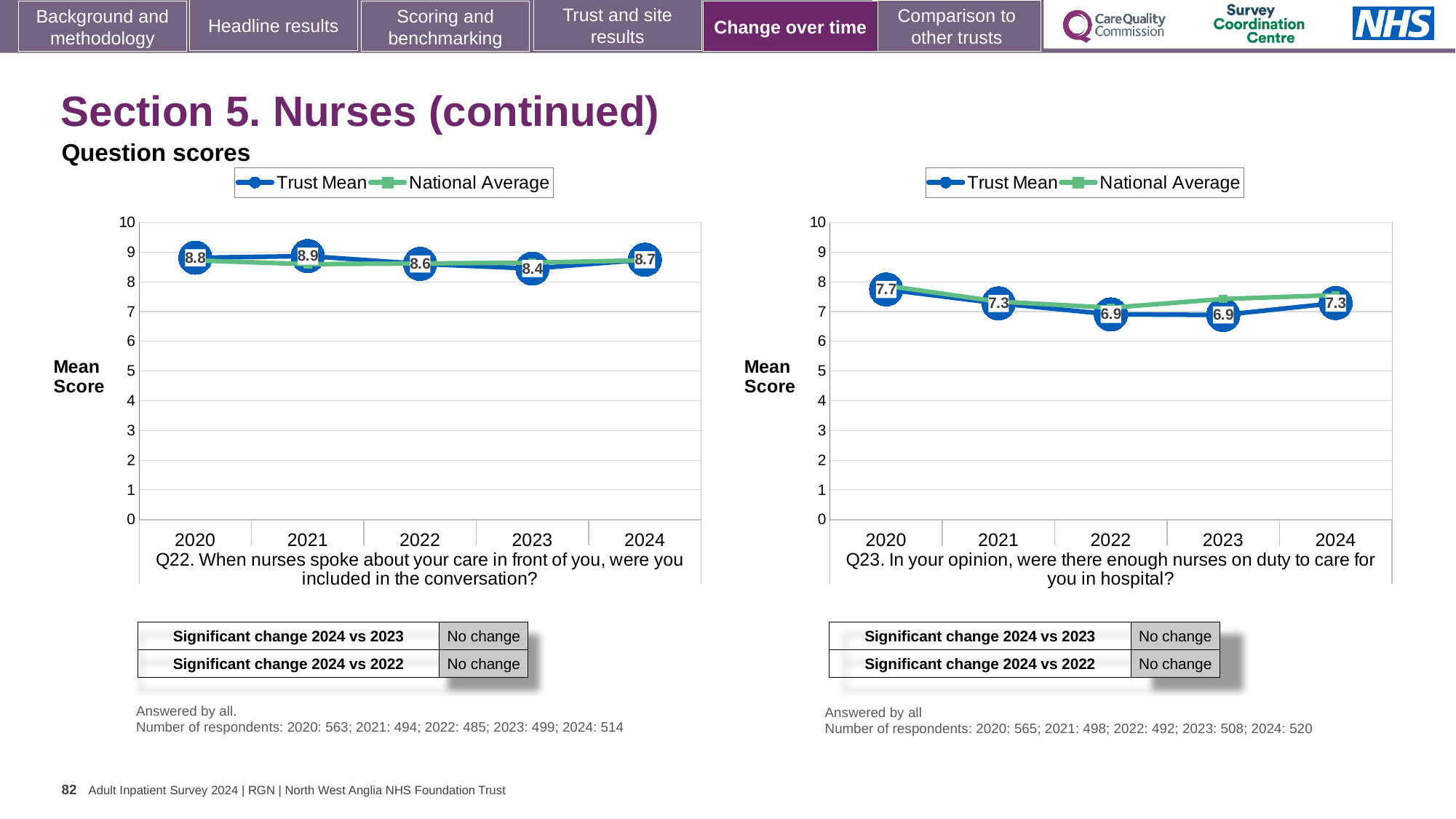
On the Q22 chart (left), what is the Trust Mean score for 2023? 8.4 How many years are plotted on the x axis of the Q22 chart (left)? 5 On the Q23 chart (right), is the Trust Mean score for 2020 greater or less than 8? less On the Q23 chart (right), what is the Trust Mean score for 2020? 7.7 On the Q23 chart (right), what is the Trust Mean score for 2024? 7.3 On the Q22 chart (left), which year has the lowest Trust Mean score? 2023 What kind of chart is the Q22 chart (left)? Line chart How many series does the legend of the Q23 chart (right) list? 2 On the Q23 chart (right), which year has the highest Trust Mean score? 2020 On the Q22 chart (left), what is the difference between the Trust Mean scores for 2021 and 2023? 0.5 On the Q23 chart (right), what is the difference between the Trust Mean scores for 2020 and 2022? 0.8 On the Q22 chart (left), what is the Trust Mean score for 2021? 8.9